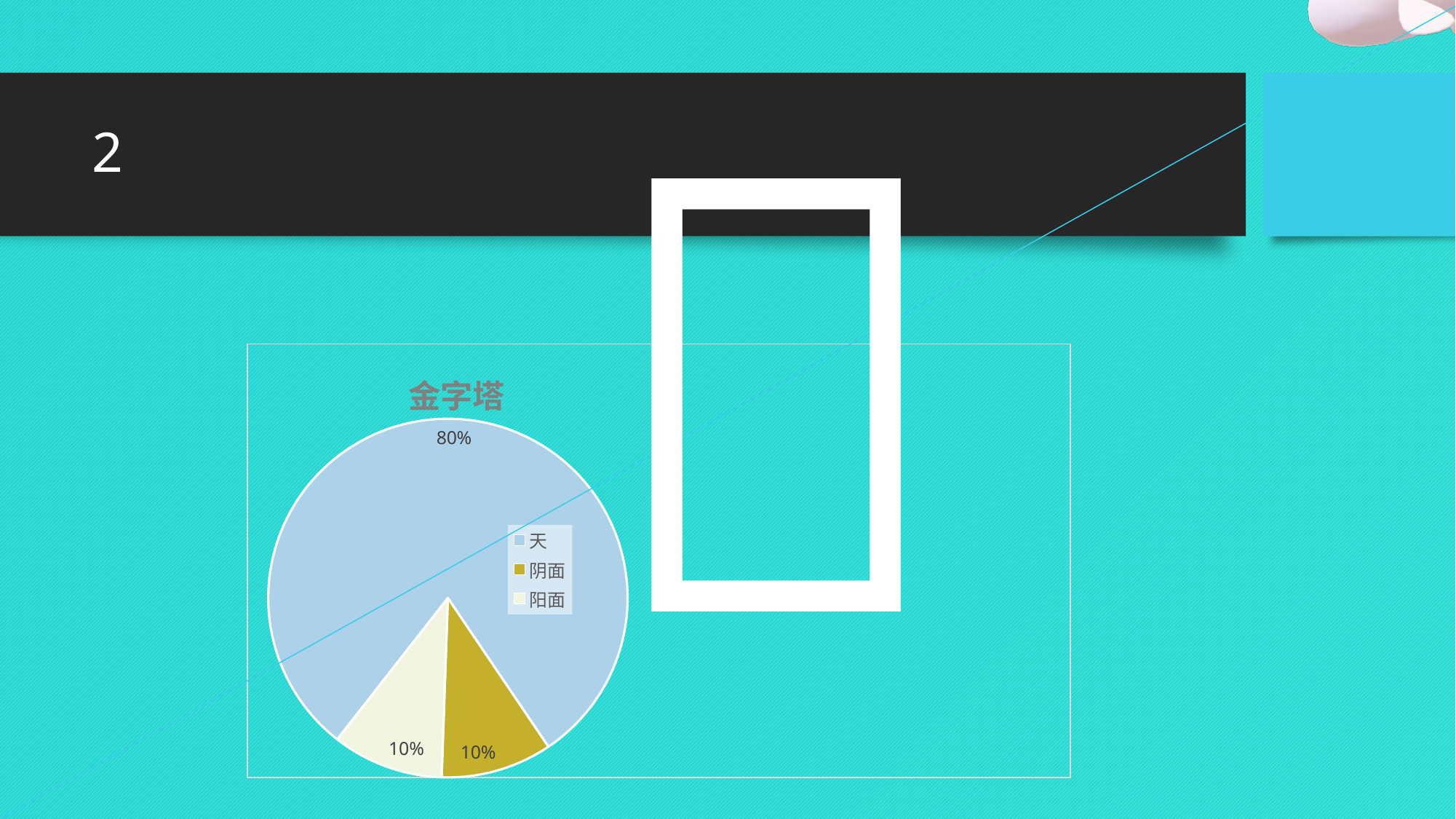
How many slices does the pie chart have? 3 Which category has the largest slice of the pie? 天 What percentage does the 阳面 slice represent? 10% What type of chart is shown on the slide? pie chart What is the title of the chart? 金字塔 How many entries does the legend list? 3 What share of the pie does 天 account for? 80% Which legend entry is shown in the darker gold colour? 阴面 What percentage does the 阴面 slice represent? 10% What percentage does the 天 slice represent? 80% Which is larger, the slice for 天 or the slice for 阴面? 天 What is the difference in percentage points between the 天 slice and the 阳面 slice? 70